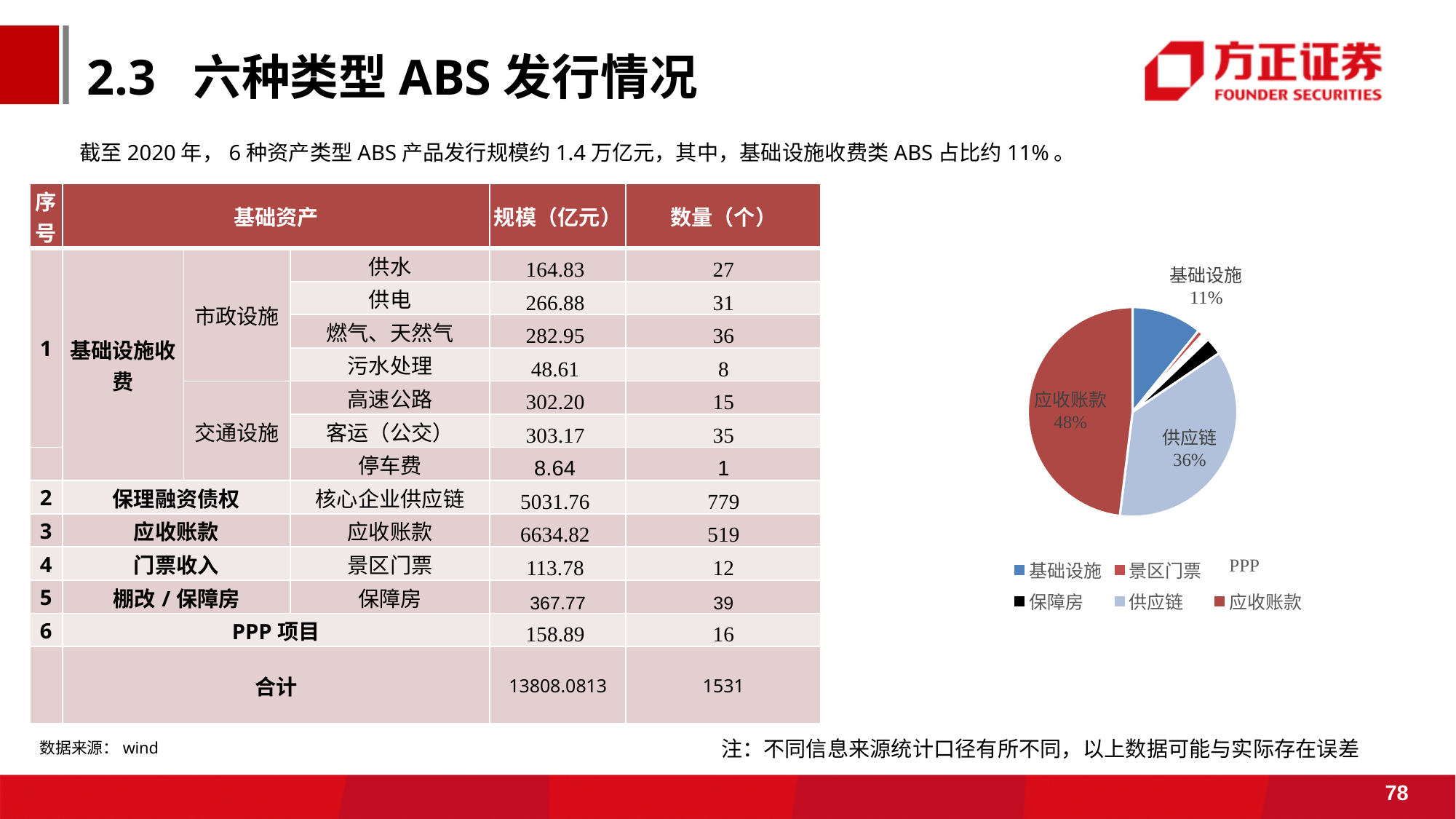
In the pie chart, which slice is larger: 供应链 or 基础设施? 供应链 In the pie chart, what share does 基础设施 account for? 11% What type of chart is shown on the right side of the slide? Pie chart In the pie chart, what share does 应收账款 account for? 48% In the pie chart, what share does 供应链 account for? 36% Which category has the largest slice in the pie chart? 应收账款 How many categories does the legend of the pie chart list? 6 In the pie chart, by how many percentage points does the 应收账款 share exceed the 供应链 share? 12 percentage points What colour is the 应收账款 slice in the pie chart? Dark red What colour is the 保障房 slice in the pie chart? Black